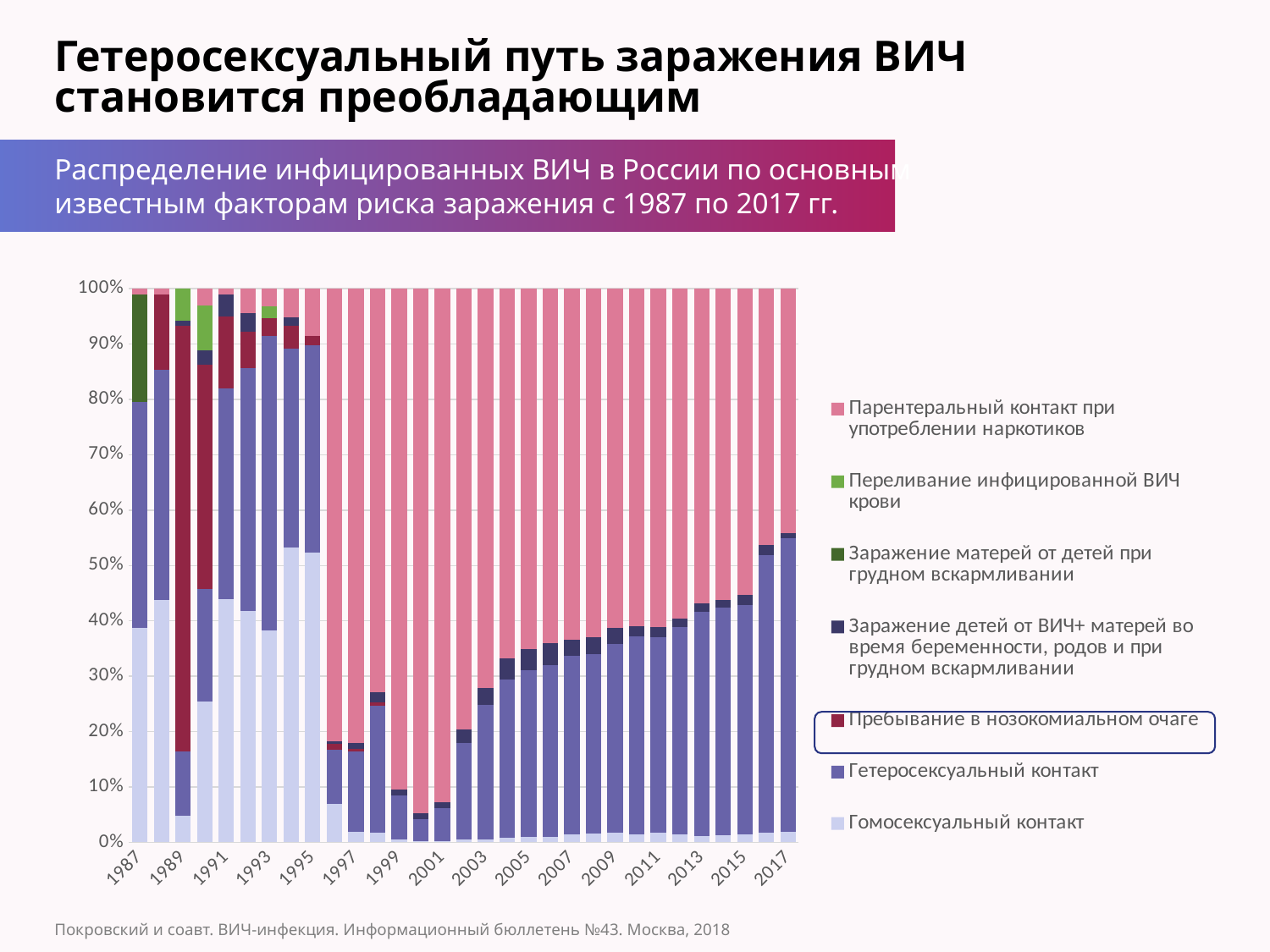
From 2001 to 2017, does the share of "Гетеросексуальный контакт" rise or fall? rise Which legend entry is highlighted with a box on the slide? Пребывание в нозокомиальном очаге In 2017, which is larger: the share of "Гетеросексуальный контакт" or the share of "Парентеральный контакт при употреблении наркотиков"? Гетеросексуальный контакт In 2005, which is larger: the share of "Парентеральный контакт при употреблении наркотиков" or the share of "Гетеросексуальный контакт"? Парентеральный контакт при употреблении наркотиков How many years (bars) are plotted on the chart, from 1987 to 2017? 31 Is the share of "Парентеральный контакт при употреблении наркотиков" in 2017 greater or less than 50%? less Is the share of "Гетеросексуальный контакт" in 2017 greater or less than 40%? greater What kind of chart is shown on the slide? Stacked bar chart Is the share of "Пребывание в нозокомиальном очаге" in 1989 greater or less than 70%? greater How many series does the chart legend list? 7